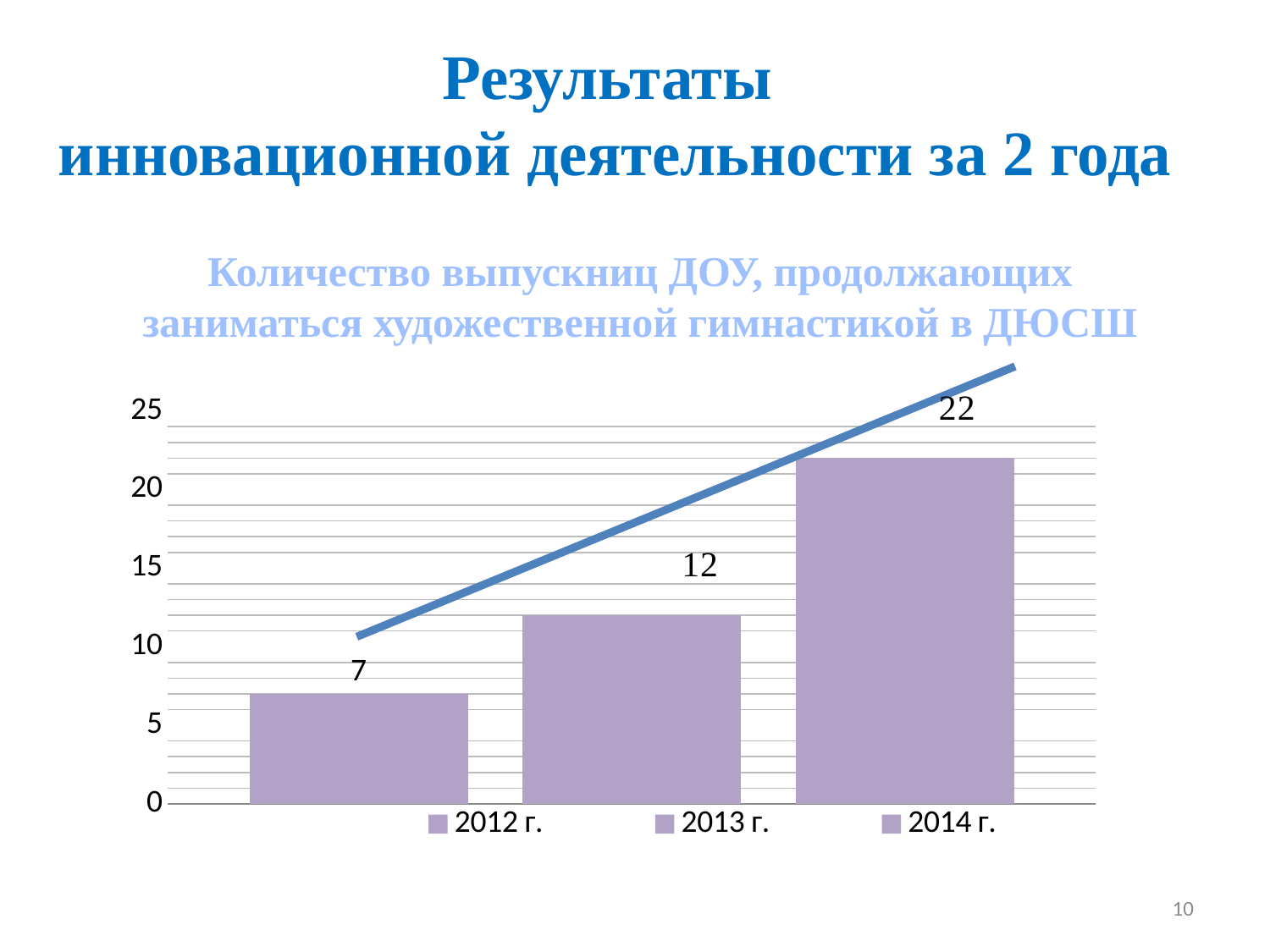
What kind of chart is shown on the slide? bar chart What is the value for 2012 г.? 7 How many bars are shown in the chart? 3 Is the value for 2014 г. greater or less than 20? greater Do the values rise or fall from 2012 г. to 2014 г.? rise Which year has the highest value? 2014 г. What is the value for 2013 г.? 12 Which is larger, the value for 2013 г. or the value for 2014 г.? 2014 г. What is the difference between the values for 2014 г. and 2012 г.? 15 What is the difference between the values for 2013 г. and 2012 г.? 5 Which year has the lowest value? 2012 г. What is the value for 2014 г.? 22